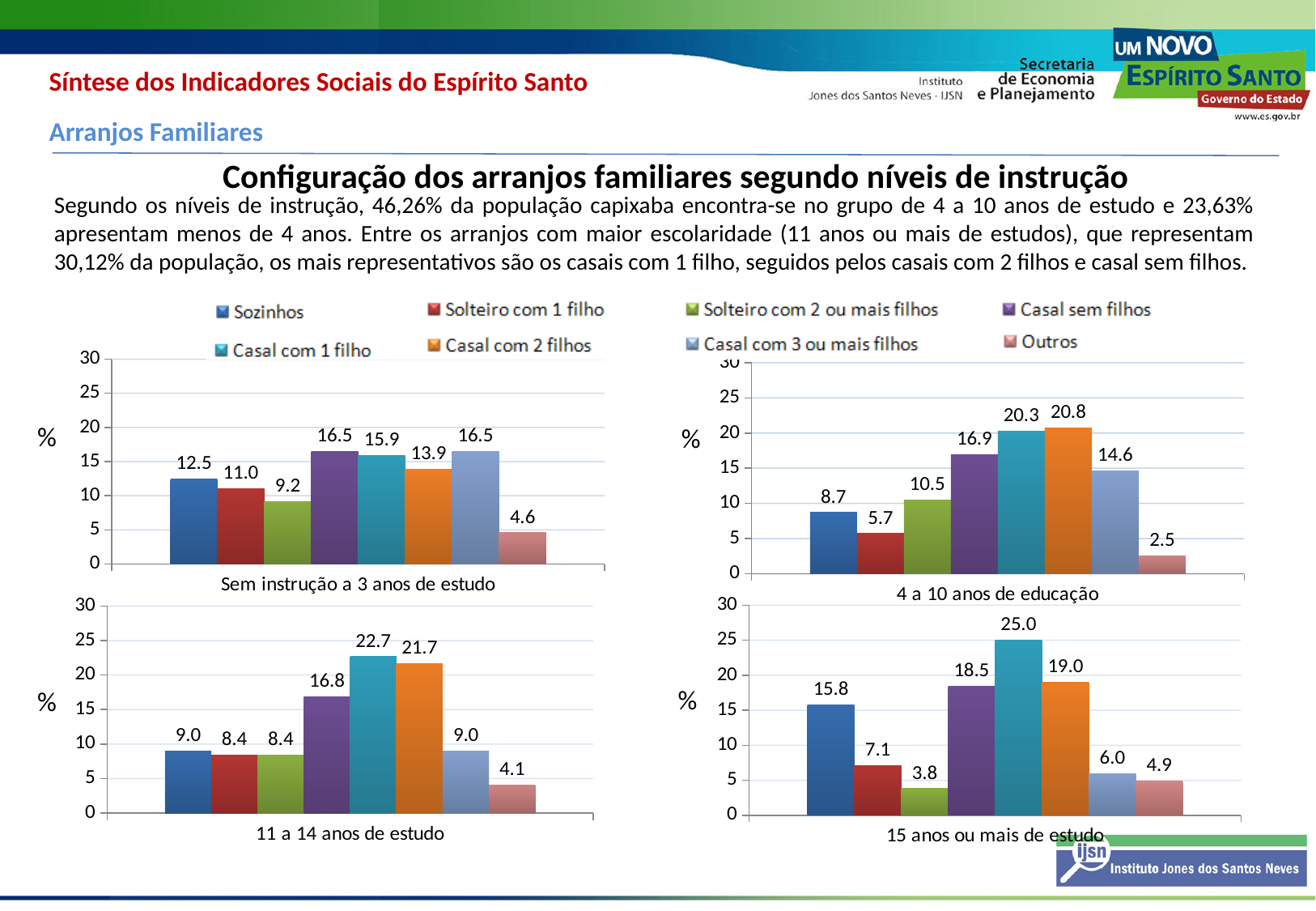
In the chart titled "15 anos ou mais de estudo", which series has the lowest value? Solteiro com 2 ou mais filhos In the chart titled "11 a 14 anos de estudo", which series has the highest value? Casal com 1 filho In the chart titled "Sem instrução a 3 anos de estudo", which is larger: Casal com 1 filho or Casal com 2 filhos? Casal com 1 filho How many bar charts are shown on the slide? 4 How many series does the shared legend list for the charts on the slide? 8 What kind of chart is the chart titled "15 anos ou mais de estudo"? bar chart In the chart titled "Sem instrução a 3 anos de estudo", what is the value for Sozinhos? 12.5 In the chart titled "15 anos ou mais de estudo", what is the difference between Casal com 1 filho and Casal com 2 filhos? 6.0 In the chart titled "4 a 10 anos de educação", what is the value for Casal com 2 filhos? 20.8 In the chart titled "4 a 10 anos de educação", which series has the lowest value? Outros In the chart titled "11 a 14 anos de estudo", what is the value for Outros? 4.1 In the chart titled "11 a 14 anos de estudo", is the value for Casal sem filhos greater or less than 15? greater